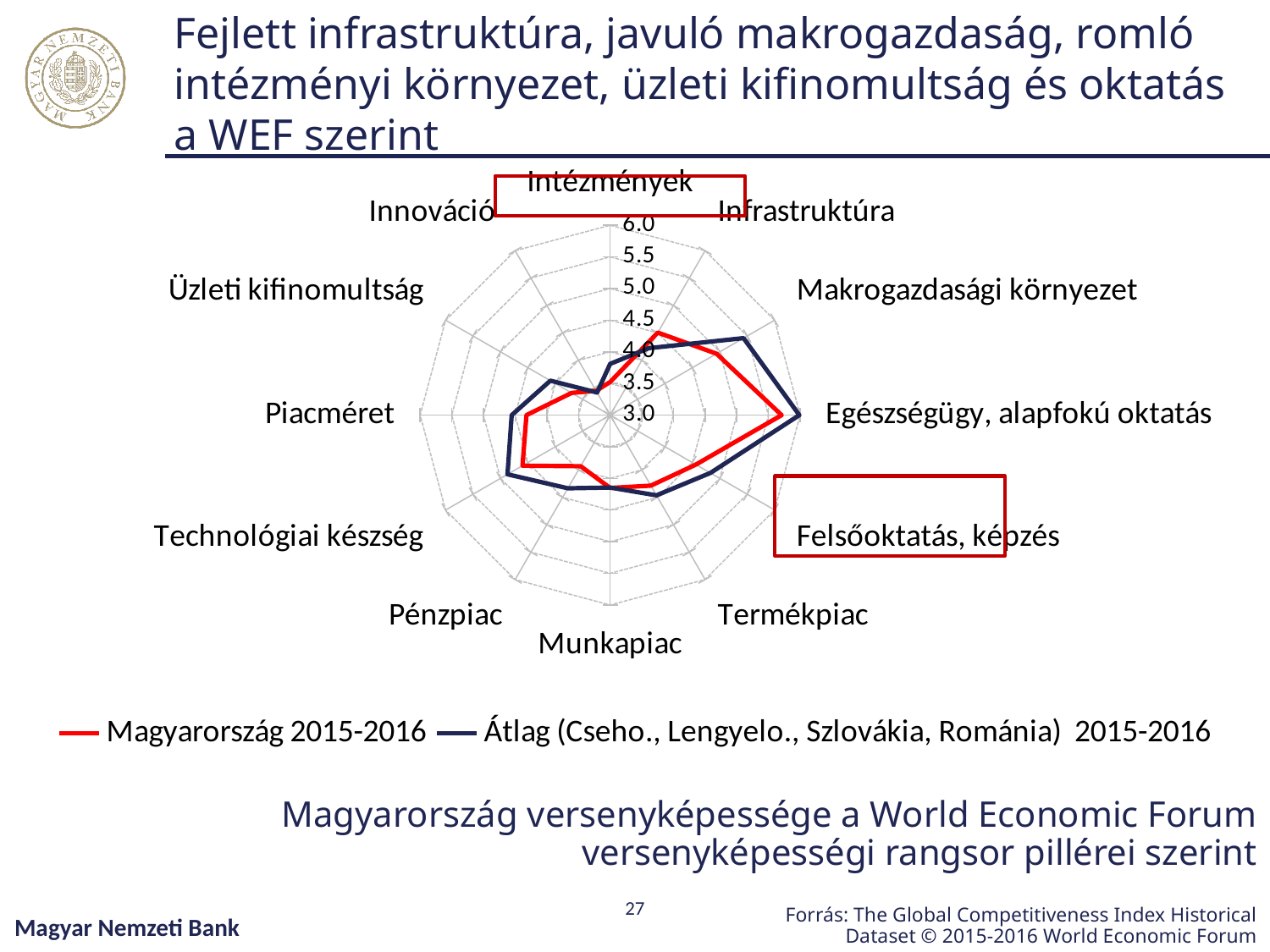
What colour is the line for the Magyarország 2015-2016 series? red Is the Magyarország 2015-2016 value for Egészségügy, alapfokú oktatás greater or less than 5.0? greater Is the Magyarország 2015-2016 value for Intézmények greater or less than 4.0? less For the Magyarország 2015-2016 series, which category has the highest value? Egészségügy, alapfokú oktatás How many categories (pillars) are plotted on the radar chart? 12 For Egészségügy, alapfokú oktatás, which series has the larger value: Magyarország 2015-2016 or Átlag (Cseho., Lengyelo., Szlovákia, Románia) 2015-2016? Átlag (Cseho., Lengyelo., Szlovákia, Románia) 2015-2016 Is the Magyarország 2015-2016 value for Innováció greater or less than 4.0? less How many series does the legend list? 2 For Makrogazdasági környezet, which series has the larger value: Magyarország 2015-2016 or Átlag (Cseho., Lengyelo., Szlovákia, Románia) 2015-2016? Átlag (Cseho., Lengyelo., Szlovákia, Románia) 2015-2016 What kind of chart is shown on the slide? radar chart What is the highest value shown on the radar chart's axis scale? 6.0